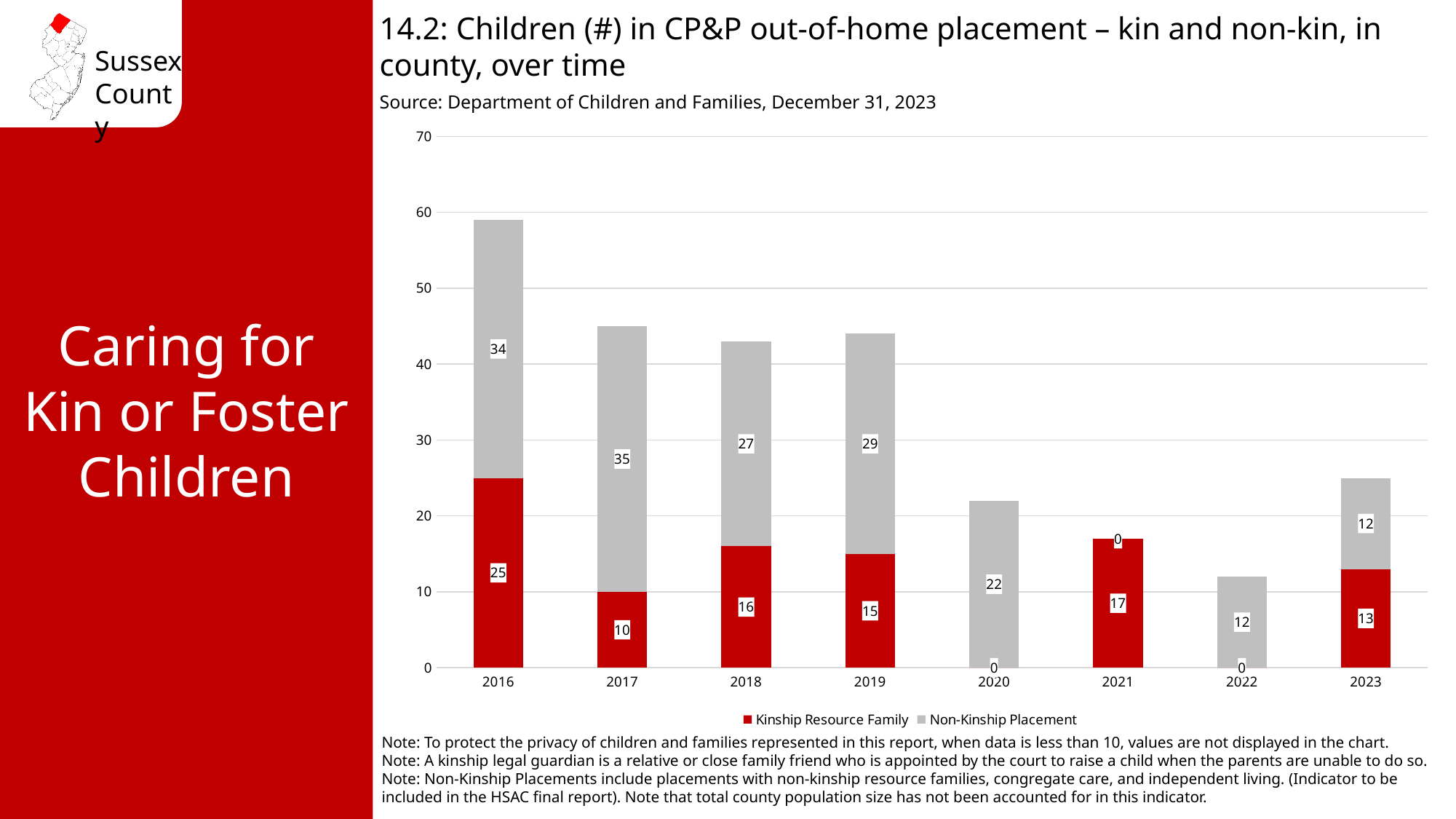
How many years are shown on the x axis? 8 How many series does the legend list? 2 What is the difference between the Non-Kinship Placement and Kinship Resource Family values in 2016? 9 What is the total height of the stacked bar for 2016? 59 What is the Non-Kinship Placement value for 2017? 35 What is the Kinship Resource Family value for 2023? 13 Is the total height of the 2020 bar greater or less than 20? greater In which year is the Kinship Resource Family value highest? 2016 What is the Non-Kinship Placement value for 2019? 29 What is the total height of the stacked bar for 2023? 25 Which is larger, the Kinship Resource Family value for 2018 or for 2019? 2018 What is the Kinship Resource Family value for 2016? 25